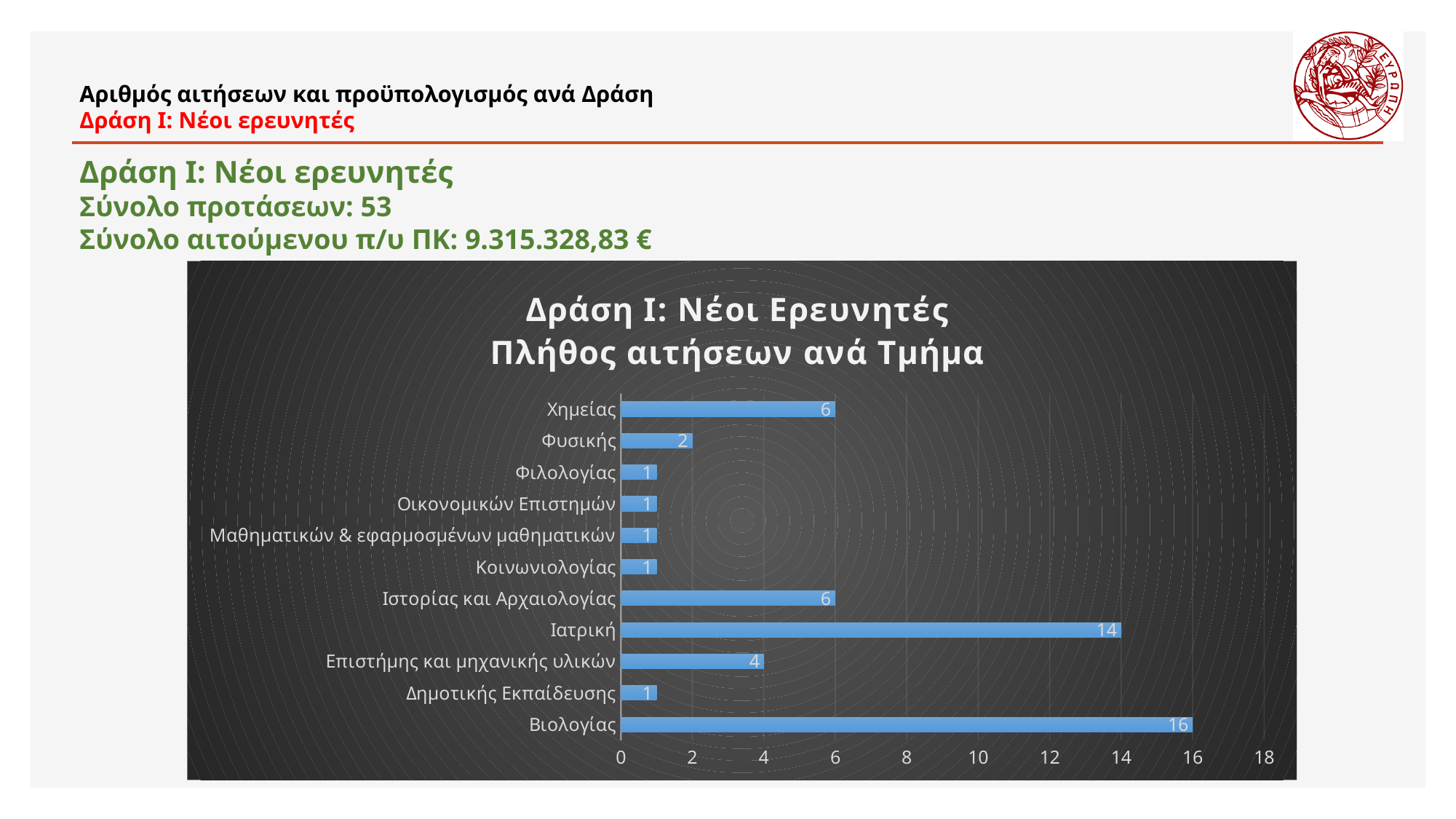
What is the difference between the values for Βιολογίας and Ιατρική? 2 What is the difference between the values for Χημείας and Φυσικής? 4 What is the value shown for Επιστήμης και μηχανικής υλικών? 4 What is the value shown for Φυσικής? 2 What is the number of applications for Βιολογίας? 16 What is the title of the chart? Δράση Ι: Νέοι Ερευνητές Πλήθος αιτήσεων ανά Τμήμα Is the value for Ιατρική greater or less than 10? greater What is the number of applications for Ιατρική? 14 Which has more applications, Ιστορίας και Αρχαιολογίας or Επιστήμης και μηχανικής υλικών? Ιστορίας και Αρχαιολογίας Which department has the highest number of applications? Βιολογίας What kind of chart is shown on the slide? Bar chart How many departments are shown in the chart? 11